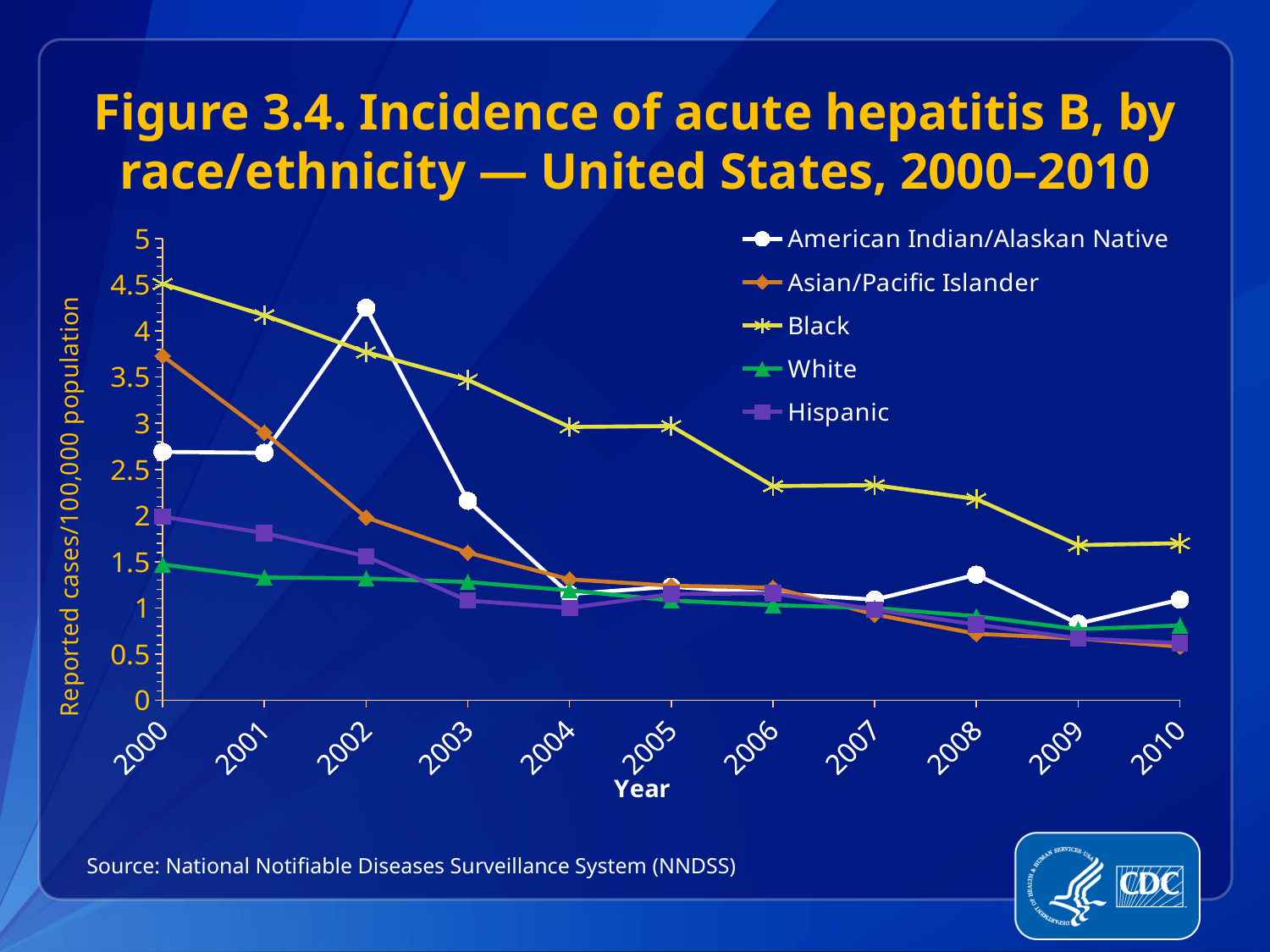
How many years are shown along the x axis? 11 Which race/ethnicity group had the lowest incidence in 2000? White In 2002, which was higher: American Indian/Alaskan Native or Black? American Indian/Alaskan Native Does the Black series rise or fall overall from 2000 to 2010? fall Is the value for American Indian/Alaskan Native in 2002 greater or less than 4? greater What is the label on the y axis? Reported cases/100,000 population Is the value for Black in 2000 greater or less than 4? greater Is the value for Asian/Pacific Islander in 2010 greater or less than 1? less How many series does the legend list? 5 Which race/ethnicity group had the highest incidence in 2010? Black Which race/ethnicity group had the highest incidence in 2000? Black What kind of chart is shown on the slide? line chart